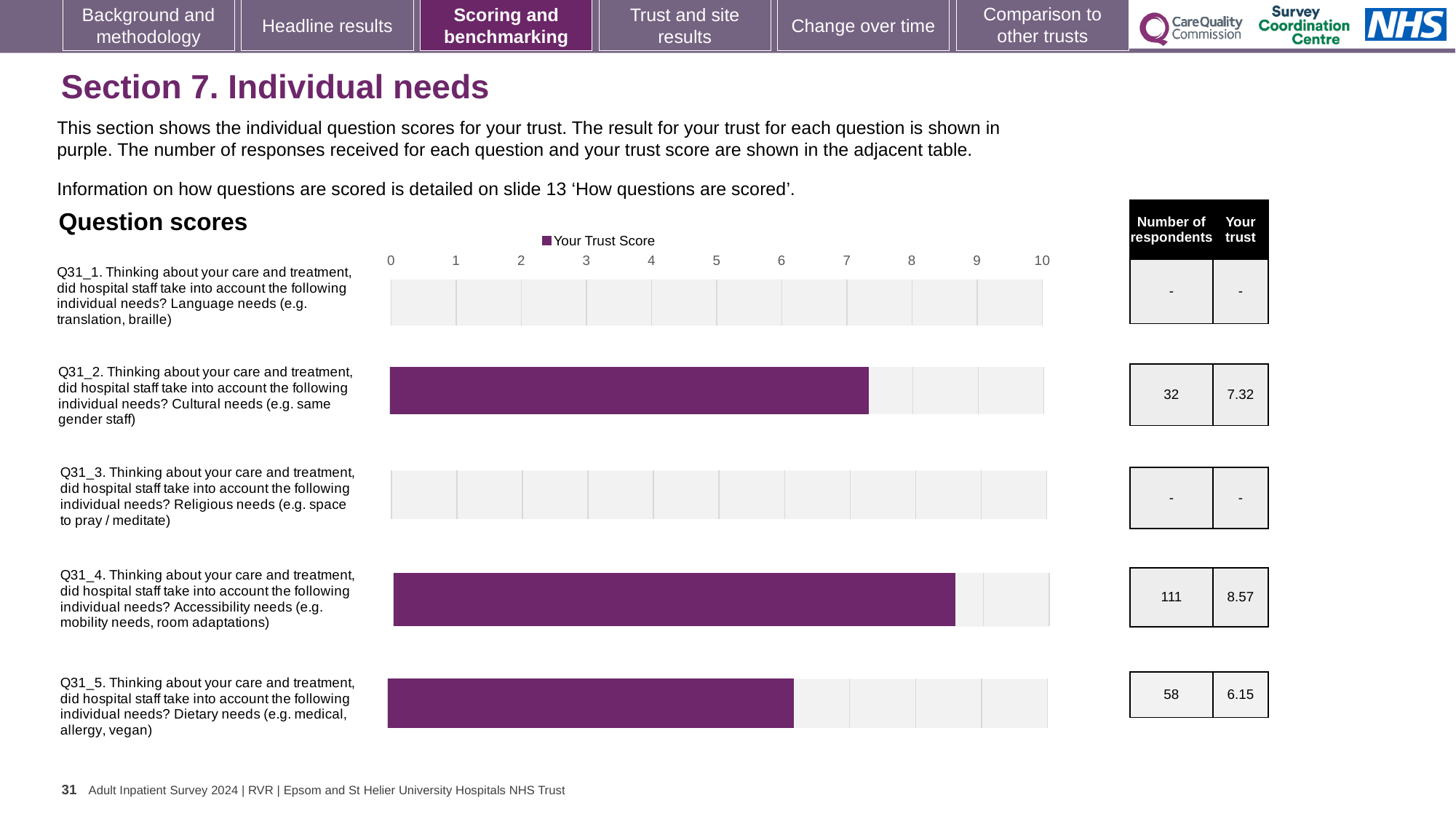
What is the trust score for Q31_4 (Accessibility needs)? 8.57 Which question has the highest trust score on the chart? Q31_4 (Accessibility needs) How many respondents answered Q31_4 (Accessibility needs)? 111 What is the trust score for Q31_2 (Cultural needs)? 7.32 Is the trust score for Q31_4 (Accessibility needs) greater or less than 8? greater What type of chart is used to show the question scores? Bar chart Among the questions with a plotted score, which has the lowest trust score? Q31_5 (Dietary needs) What is the difference between the trust scores for Q31_4 and Q31_5? 2.42 What series name is shown in the chart legend? Your Trust Score How many questions are listed on the chart? 5 What is the trust score for Q31_5 (Dietary needs)? 6.15 Which has the larger trust score, Q31_2 (Cultural needs) or Q31_5 (Dietary needs)? Q31_2 (Cultural needs)